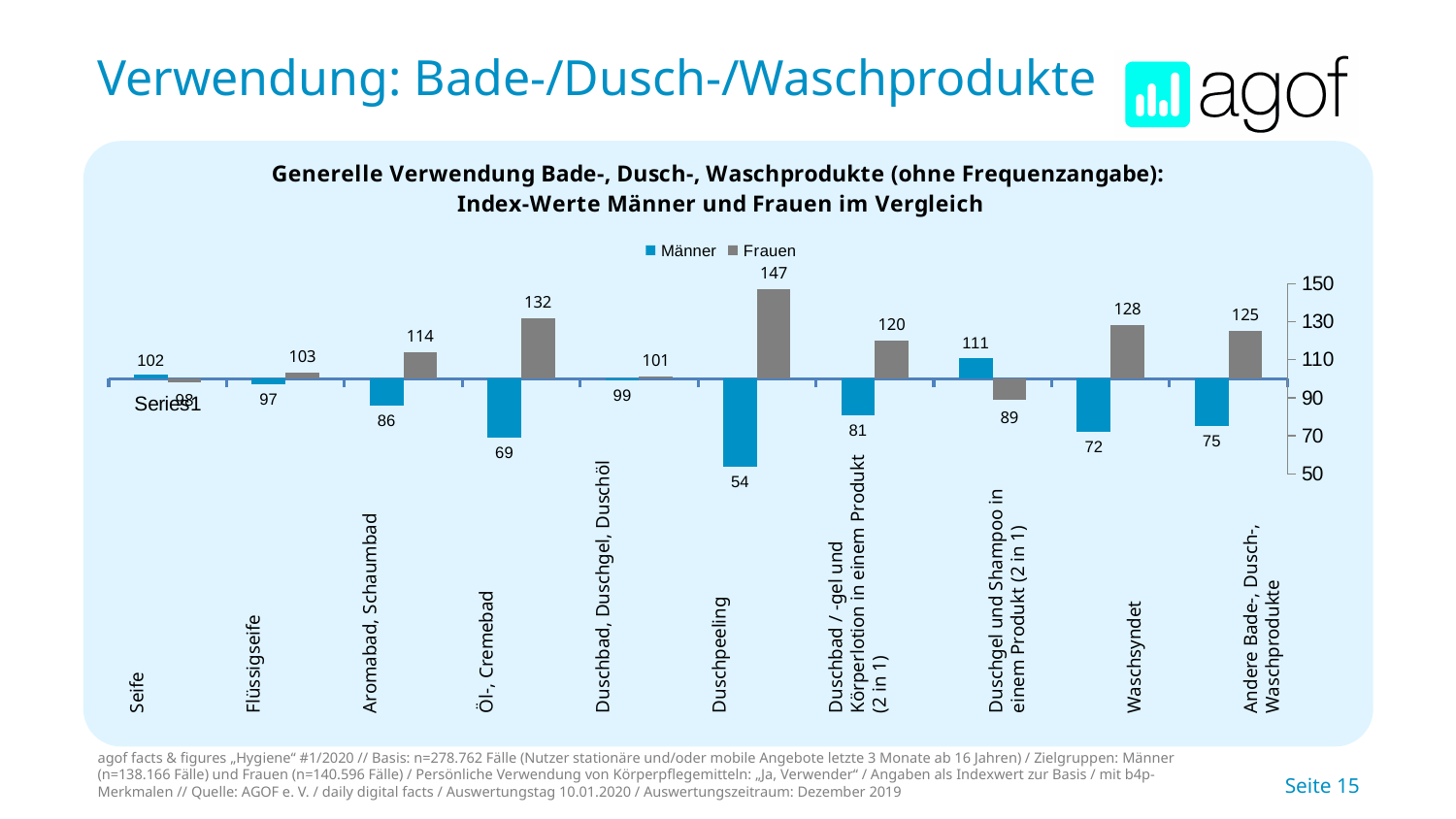
What is the difference between the Frauen and Männer index values for Duschpeeling? 93 What is the Frauen index value for Waschsyndet? 128 What is the Männer index value for Öl-, Cremebad? 69 Which category has the highest Frauen index value? Duschpeeling How many series does the legend list? 2 Which category has the lowest Männer index value? Duschpeeling Which colour represents the Männer series in the chart? Blue How many product categories are shown on the x axis? 10 Which is larger for Aromabad, Schaumbad: the Männer value or the Frauen value? Frauen What is the Männer index value for Duschgel und Shampoo in einem Produkt (2 in 1)? 111 What kind of chart is shown on the slide? Bar chart What is the Frauen index value for Duschpeeling? 147